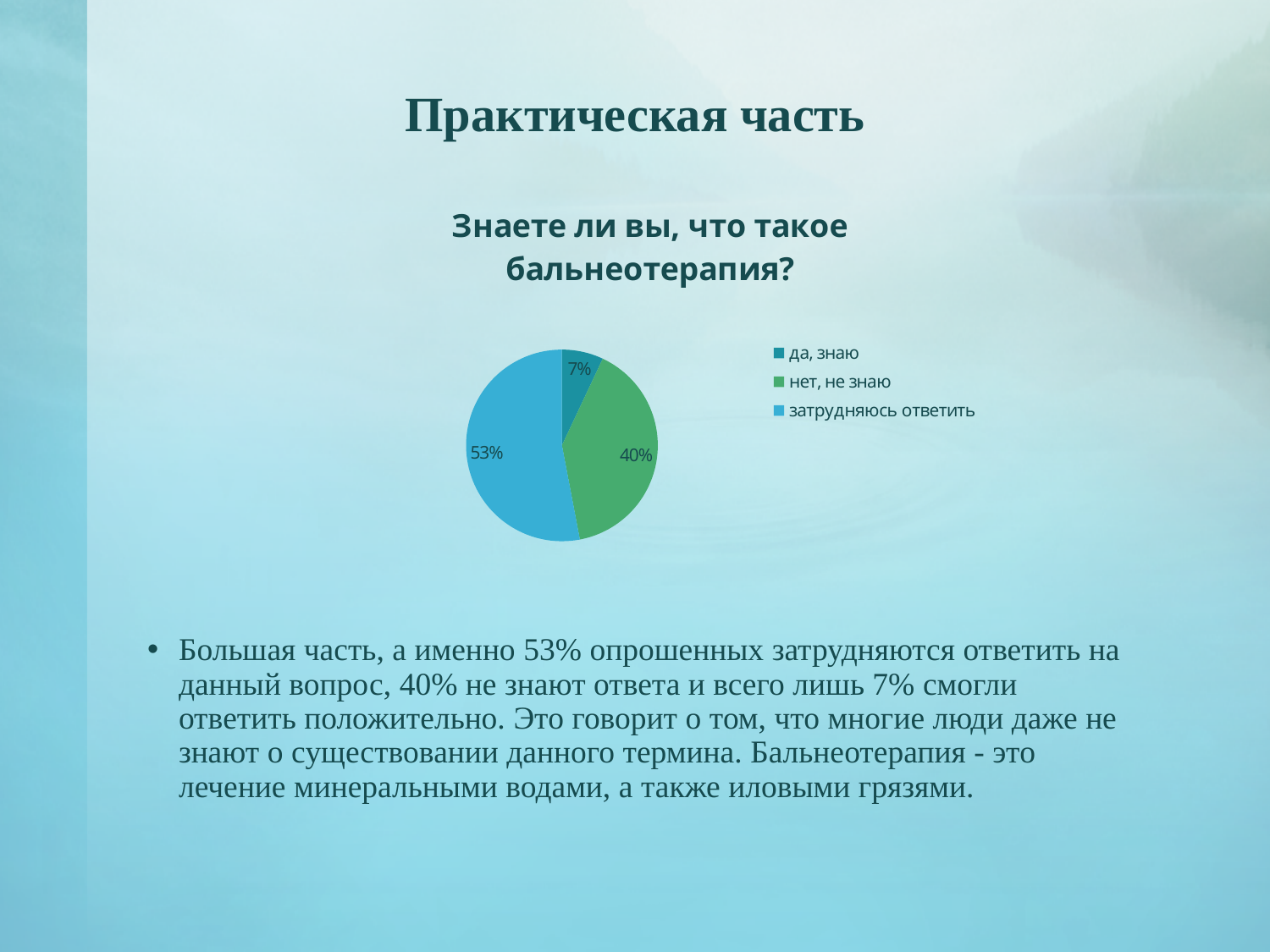
What share of respondents answered "да, знаю"? 7% What colour is the slice for "нет, не знаю"? green Which answer has the largest share of the pie? затрудняюсь ответить How many slices does the pie chart have? 3 How many entries does the legend list? 3 What is the title of the chart? Знаете ли вы, что такое бальнеотерапия? What share of respondents answered "нет, не знаю"? 40% Which is larger, the share for "нет, не знаю" or the share for "да, знаю"? нет, не знаю What share of respondents answered "затрудняюсь ответить"? 53% What kind of chart is shown on the slide? pie chart Which answer has the smallest share of the pie? да, знаю What is the difference in percentage points between "затрудняюсь ответить" and "нет, не знаю"? 13